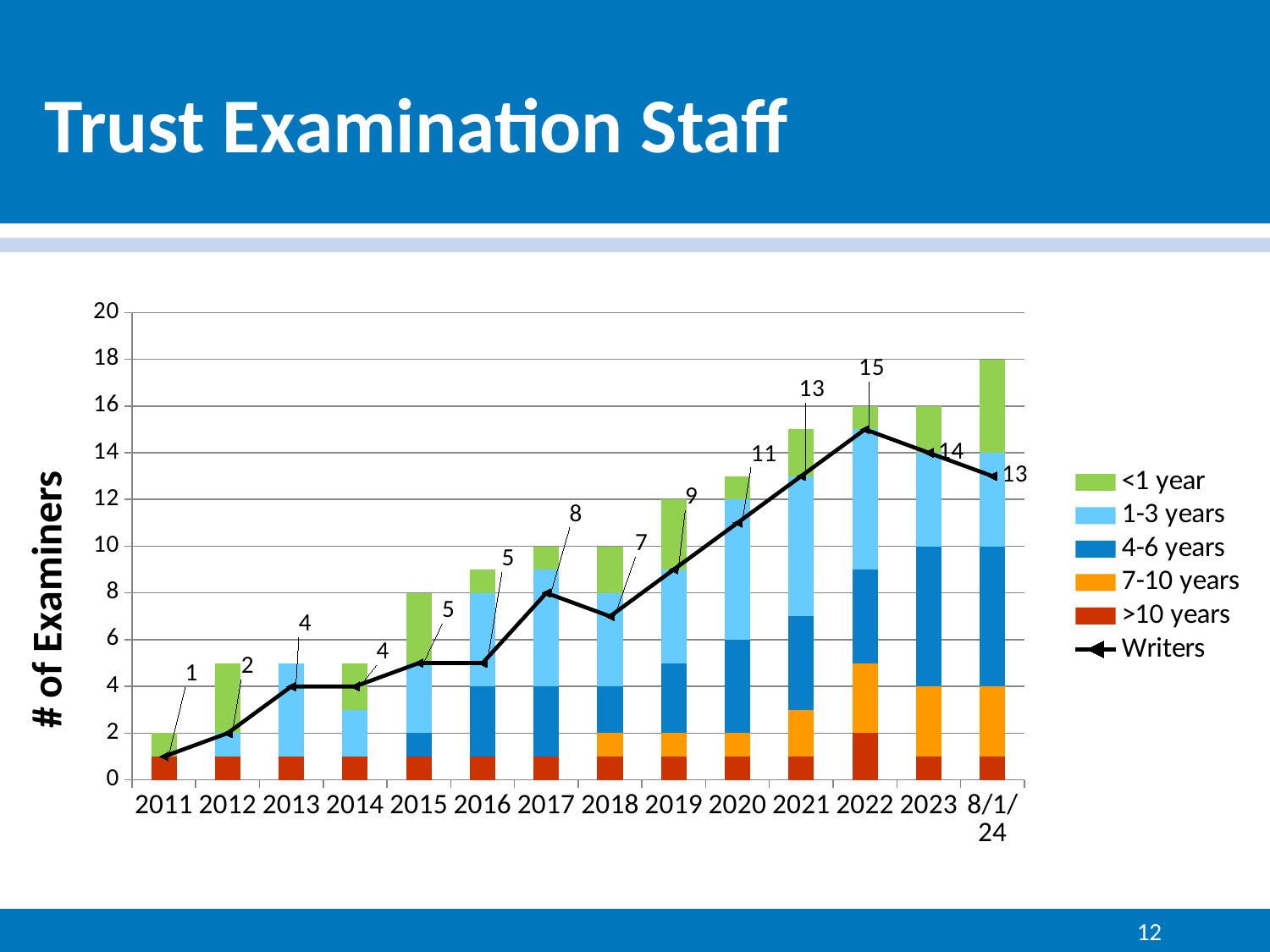
What is the difference between the Writers values for 2021 and 2019? 4 How many series does the legend list? 6 In which year does the Writers line reach its highest value? 2022 Is the total height of the stacked bar for 8/1/24 greater or less than 16? greater In which year is the Writers line at its lowest value? 2011 What is the label on the vertical axis? # of Examiners What kind of chart is shown on the slide? Stacked bar chart with a line series What is the value of the Writers line for 2022? 15 What is the value of the Writers line for 2011? 1 Which year has the larger Writers value, 2017 or 2018? 2017 What is the value of the Writers line for 8/1/24? 13 How many time periods are shown on the x axis? 14